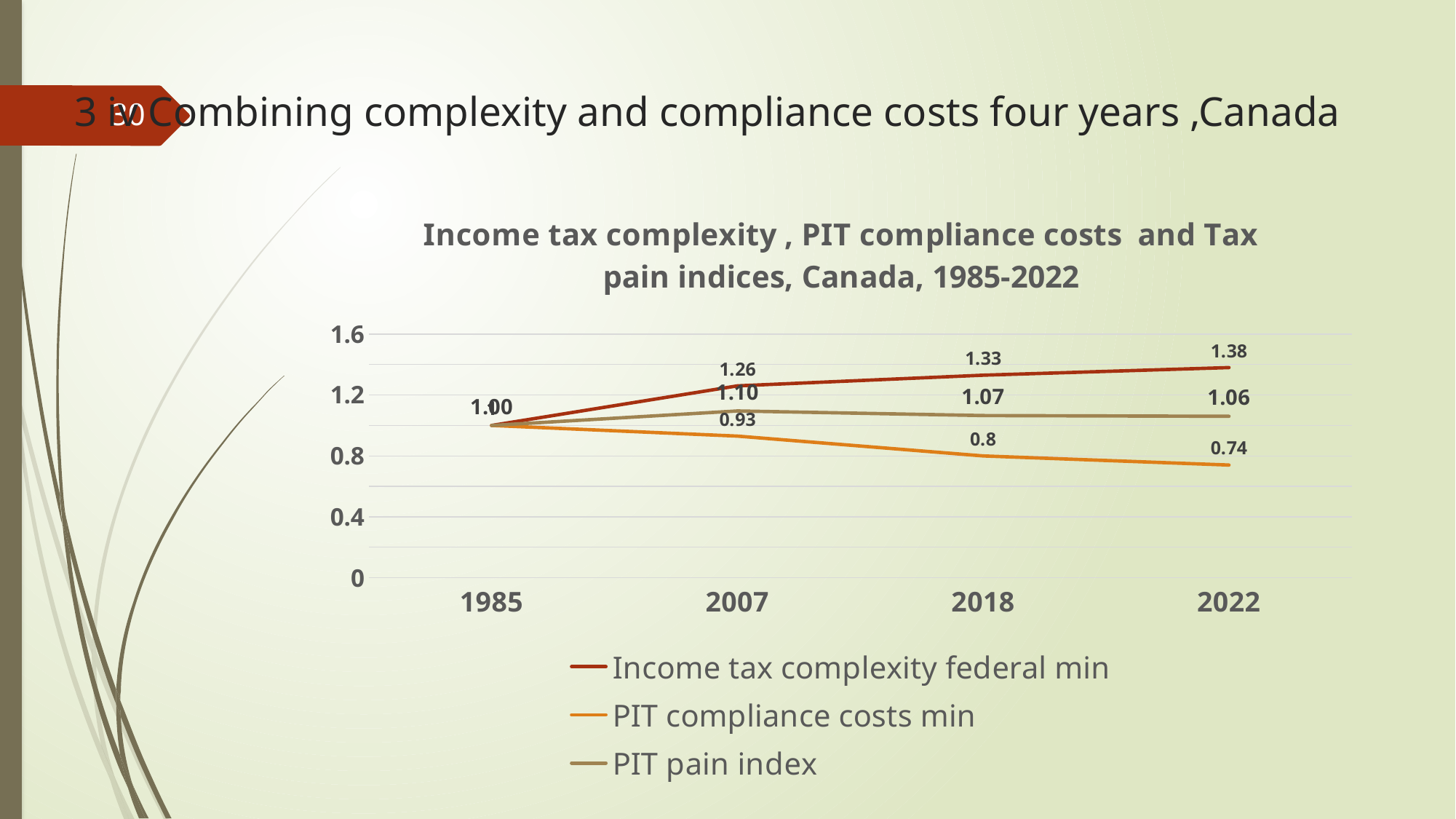
What is the value of Income tax complexity federal min in 2022? 1.38 Which is larger in 2018, PIT pain index or PIT compliance costs min? PIT pain index How many series does the legend list? 3 In which year is Income tax complexity federal min highest? 2022 Does PIT compliance costs min rise or fall from 1985 to 2022? fall What is the difference between Income tax complexity federal min and PIT compliance costs min in 2022? 0.64 How many years are shown on the x axis? 4 In which year is PIT compliance costs min lowest? 2022 What is the value of PIT compliance costs min in 2022? 0.74 What is the value of PIT pain index in 2007? 1.10 What kind of chart is shown on the slide? line chart What is the value of PIT compliance costs min in 2018? 0.8